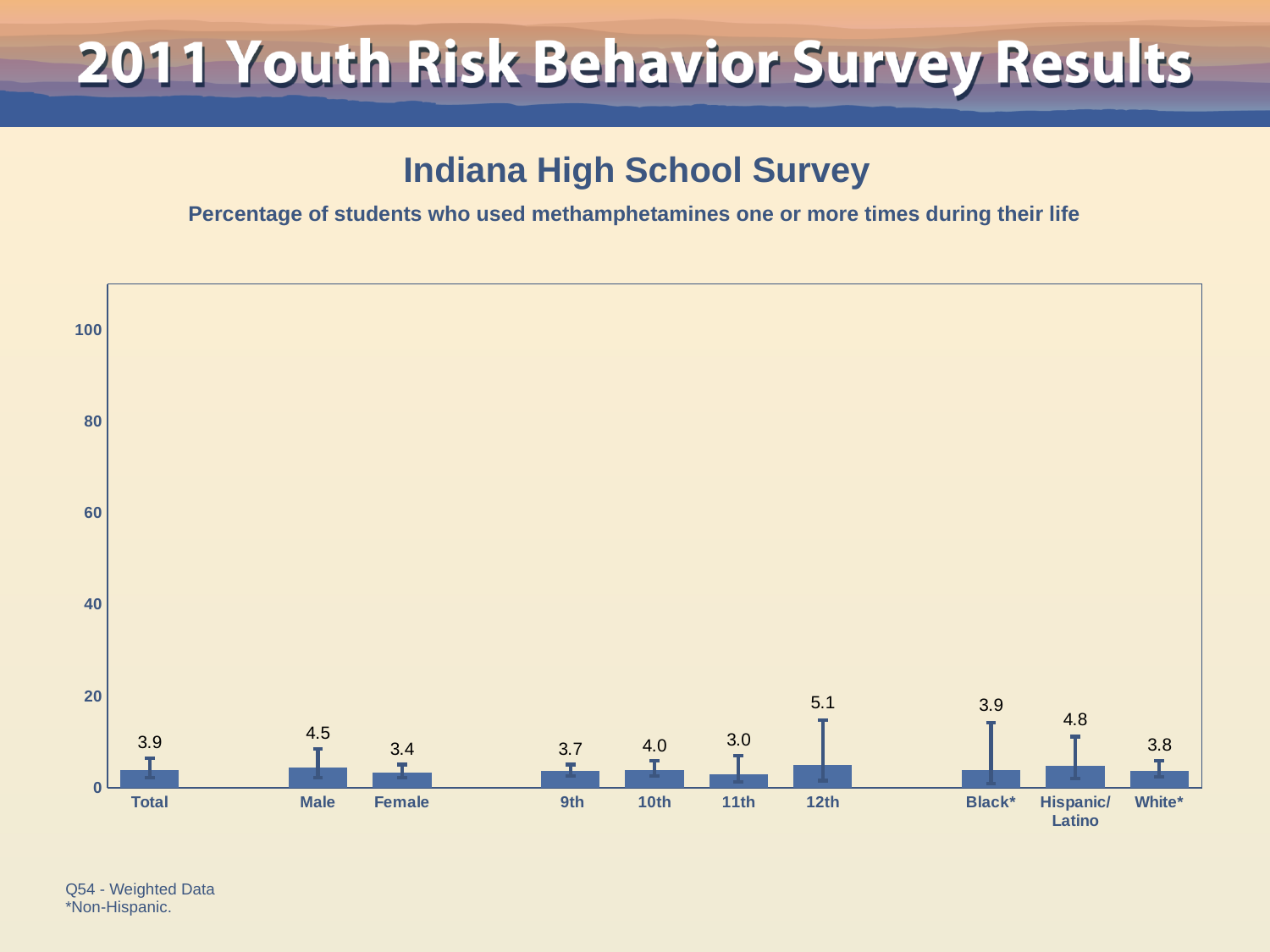
Is the value for 12th greater or less than 20? less What kind of chart is this? bar chart What is the value for Total? 3.9 What is the subtitle describing the measure plotted in the chart? Percentage of students who used methamphetamines one or more times during their life What is the value for 12th? 5.1 Which category has the highest value? 12th What is the value for Male? 4.5 What is the difference between the values for Male and Female? 1.1 What is the value for Hispanic/Latino? 4.8 Which category has the lowest value? 11th Which is larger, the value for 10th or the value for 11th? 10th How many categories are shown on the x axis? 10